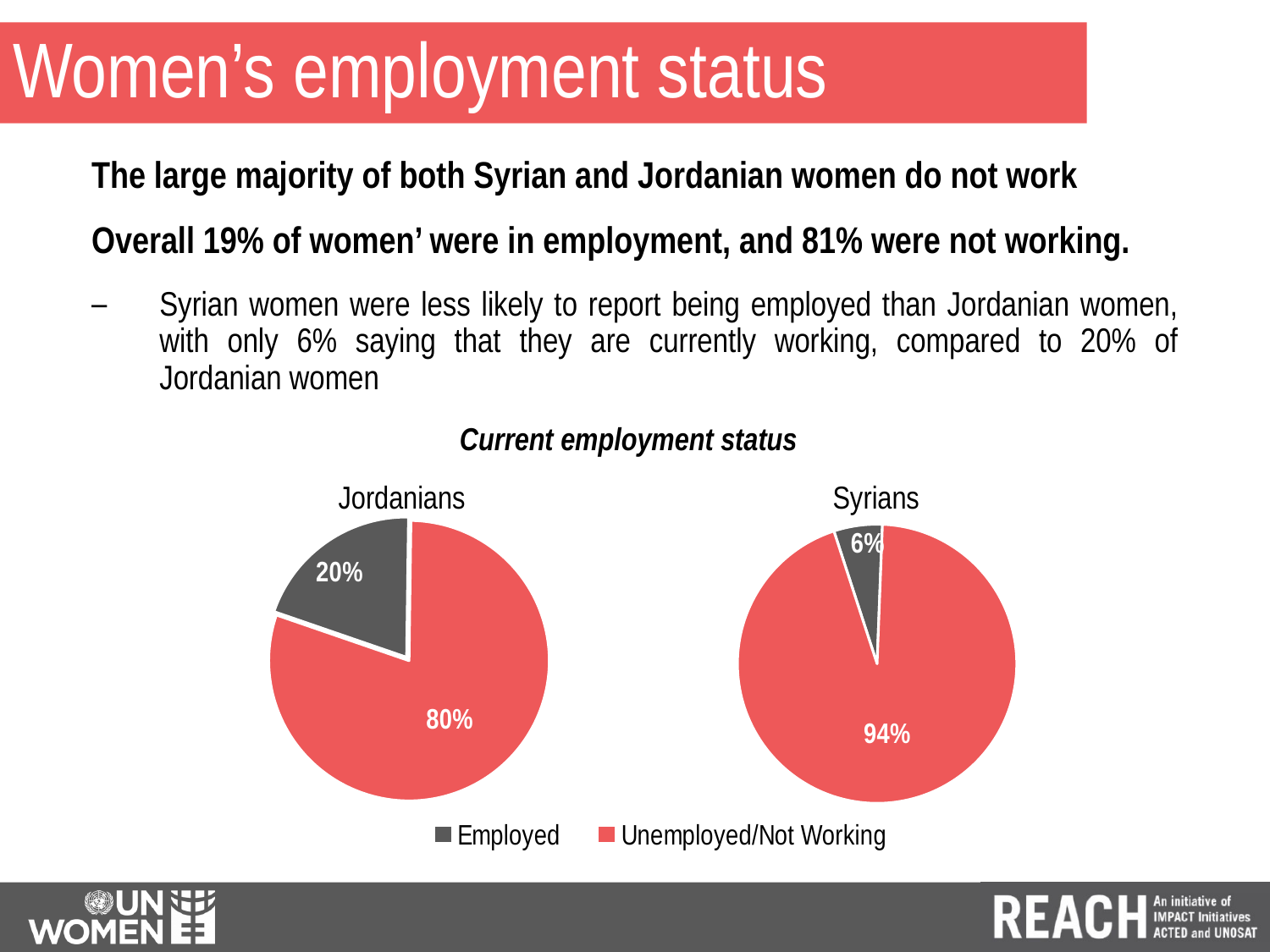
In the Jordanians pie chart, what percentage of women are Employed? 20% What is the title shown above the two pie charts? Current employment status In the Syrians pie chart, what percentage of women are Unemployed/Not Working? 94% What is the difference between the Employed share in the Jordanians pie chart and the Employed share in the Syrians pie chart? 14% What type of charts are shown on the slide? Pie charts In the pie charts, which colour represents Unemployed/Not Working? Red Which pie chart shows a larger Employed share, Jordanians or Syrians? Jordanians In the Syrians pie chart, which category has the largest slice? Unemployed/Not Working In the Syrians pie chart, what percentage of women are Employed? 6% How many categories does the legend list for the pie charts? 2 In the Jordanians pie chart, which category has the smallest slice? Employed In the Jordanians pie chart, what percentage of women are Unemployed/Not Working? 80%